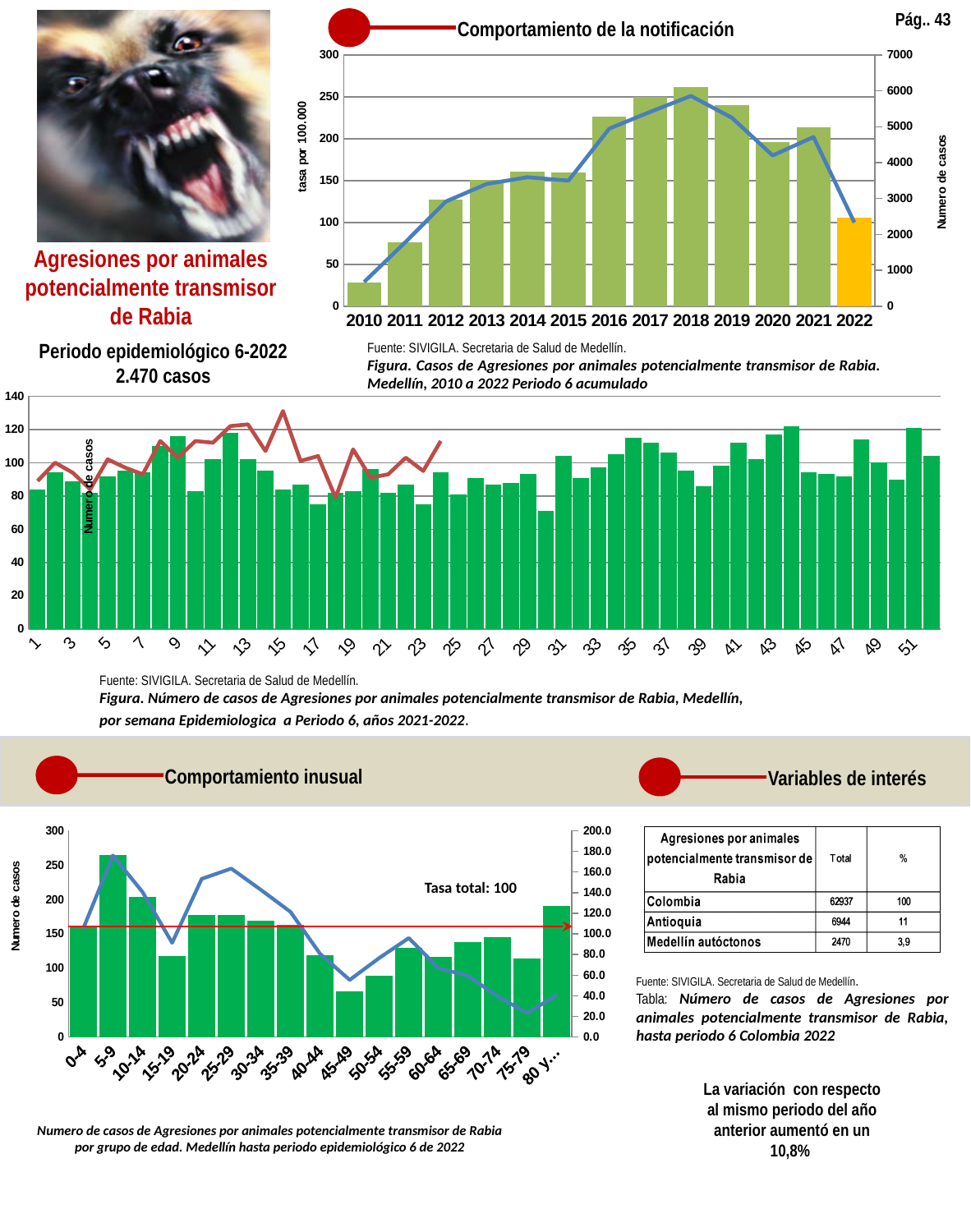
In the top-right chart 'Comportamiento de la notificación', is the number of cases bar for 2018 greater or less than 5000? greater In the top-right chart 'Comportamiento de la notificación', which year has the lowest bar for number of cases? 2010 In the bottom-left chart of cases by age group, which age group has the highest bar? 5-9 In the middle chart of cases by epidemiological week, is the bar for week 30 greater or less than 80? less In the top-right chart 'Comportamiento de la notificación', what colour is the bar for 2022? Orange In the top-right chart 'Comportamiento de la notificación', which year has the highest bar for number of cases? 2018 In the bottom-left chart of cases by age group, which bar is taller: 0-4 or 10-14? 10-14 In the bottom-left chart of cases by age group, which age group has the lowest bar? 45-49 In the top-right chart 'Comportamiento de la notificación', is the number of cases bar for 2022 greater or less than 3000? less In the bottom-left chart of cases by age group, how many age groups are shown on the x axis? 17 In the top-right chart 'Comportamiento de la notificación', how many years are shown on the x axis? 13